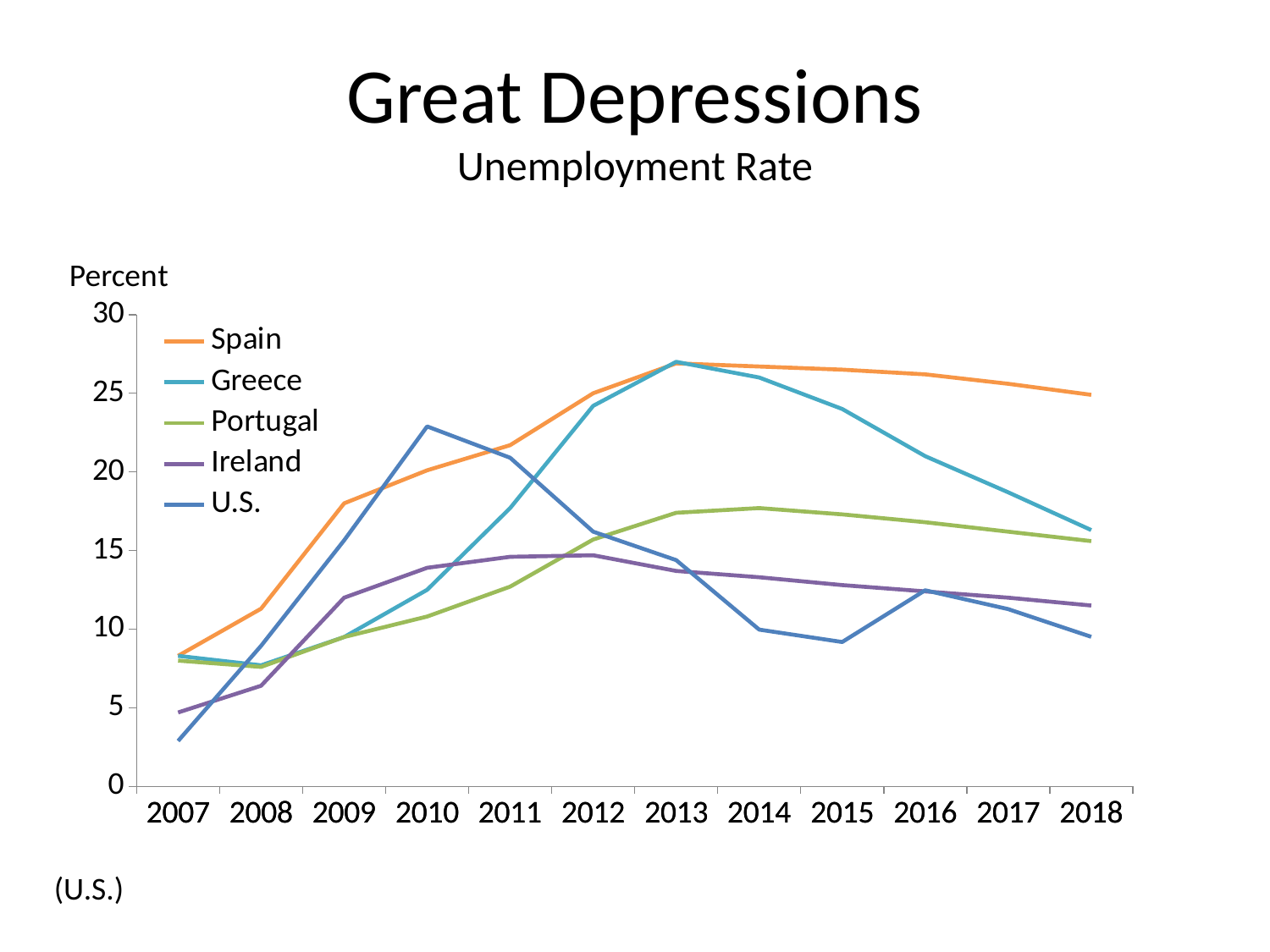
Is the value for Portugal in 2014 greater or less than 15? greater In 2018, which is larger, the value for Spain or the value for Greece? Spain Does the value for Spain rise or fall from 2007 to 2013? rise Is the value for the U.S. in 2007 greater or less than 5? less What is the label on the vertical axis? Percent How many years are shown along the x axis? 12 Does the value for Greece rise or fall from 2013 to 2018? fall What kind of chart is shown on the slide? line chart Which series has the highest value in 2010? U.S. Which series has the lowest value in 2007? U.S. How many series does the legend list? 5 Is the value for Spain in 2013 greater or less than 25? greater